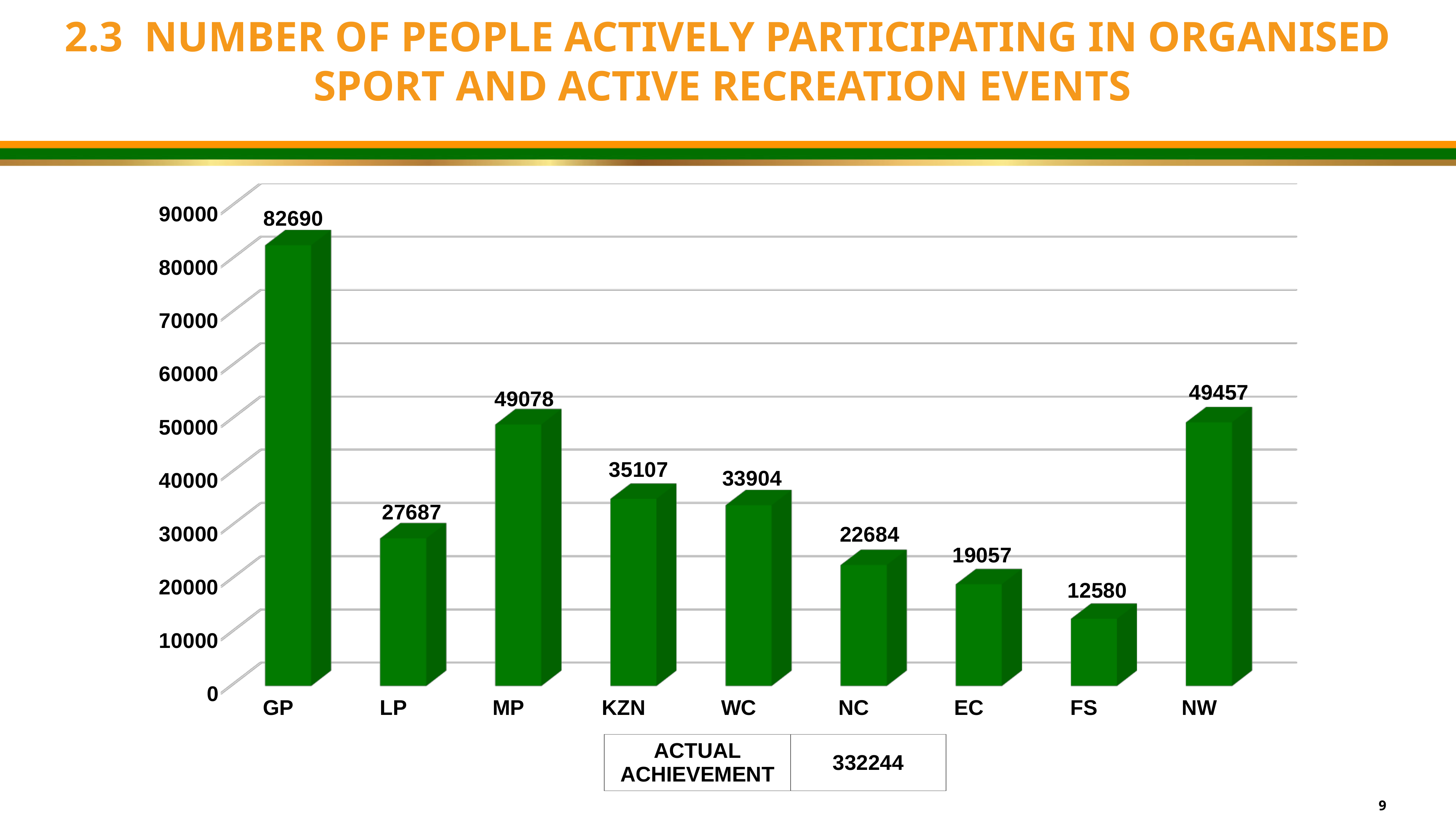
What is the difference between the values for NW and MP? 379 Which province has the lowest number of people participating? FS What is the difference between the values for GP and LP? 55003 What is the value for FS? 12580 What is the actual achievement total shown in the table below the chart? 332244 Is the value for LP greater or less than 30000? less Which is larger, the value for KZN or the value for NC? KZN What is the value for NW? 49457 What kind of chart is shown on the slide? bar chart Which province has the highest number of people participating? GP What is the value for GP? 82690 How many provinces are shown on the x axis? 9